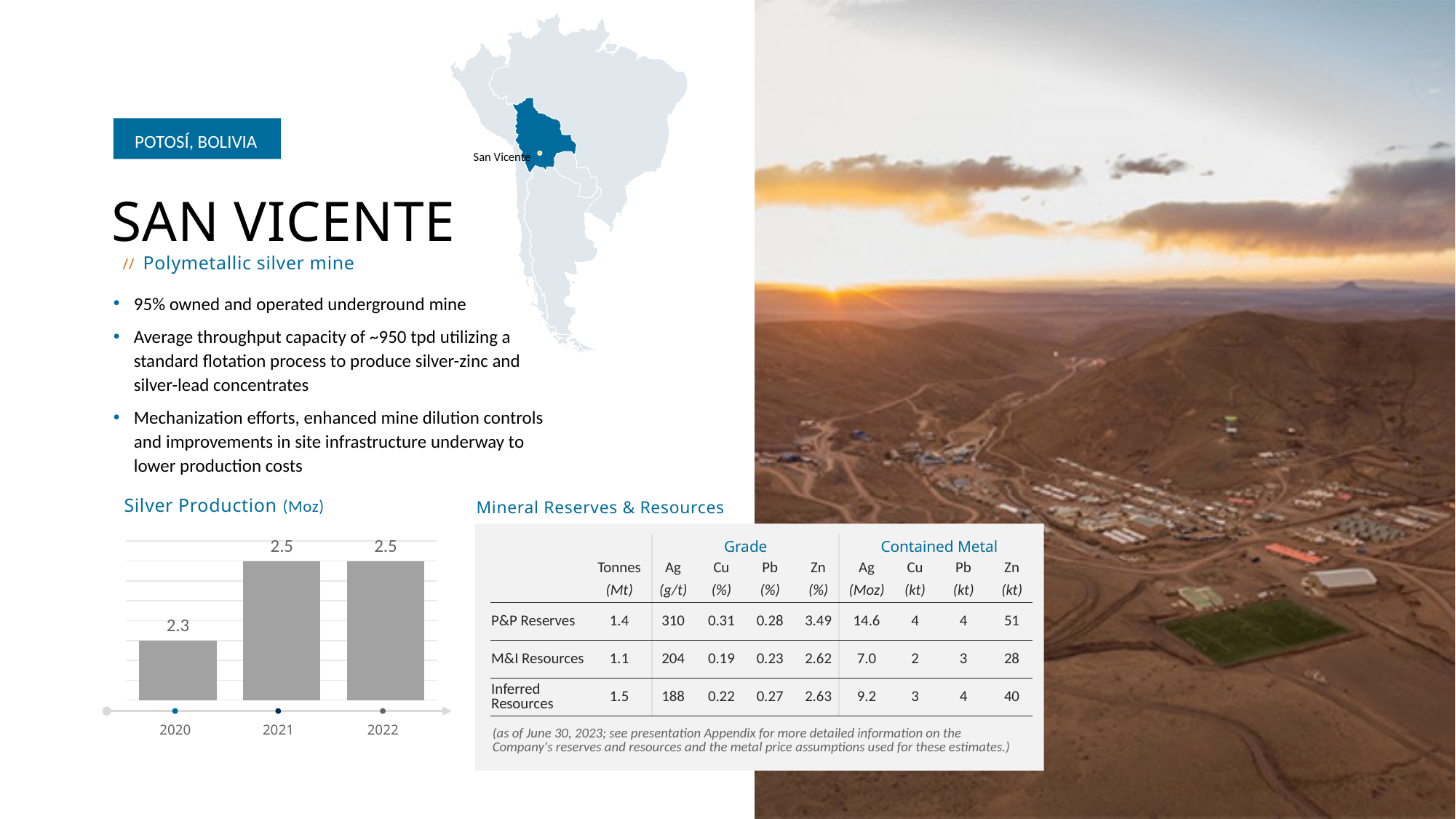
What is the silver production value for 2020 in the Silver Production chart? 2.3 What type of chart is the Silver Production chart? bar chart In the Silver Production chart, is the value for 2022 larger than, smaller than, or equal to the value for 2021? equal What is the difference in silver production between 2021 and 2020 in the Silver Production chart? 0.2 Does silver production rise or fall from 2020 to 2021 in the Silver Production chart? rise What is the silver production value for 2021 in the Silver Production chart? 2.5 Which year has the lowest silver production in the Silver Production chart? 2020 How many years are shown in the Silver Production chart? 3 What is the title of the bar chart on the slide? Silver Production (Moz) What unit is silver production measured in, according to the Silver Production chart title? Moz What is the silver production value for 2022 in the Silver Production chart? 2.5 In the Silver Production chart, is the value for 2020 larger or smaller than the value for 2021? smaller